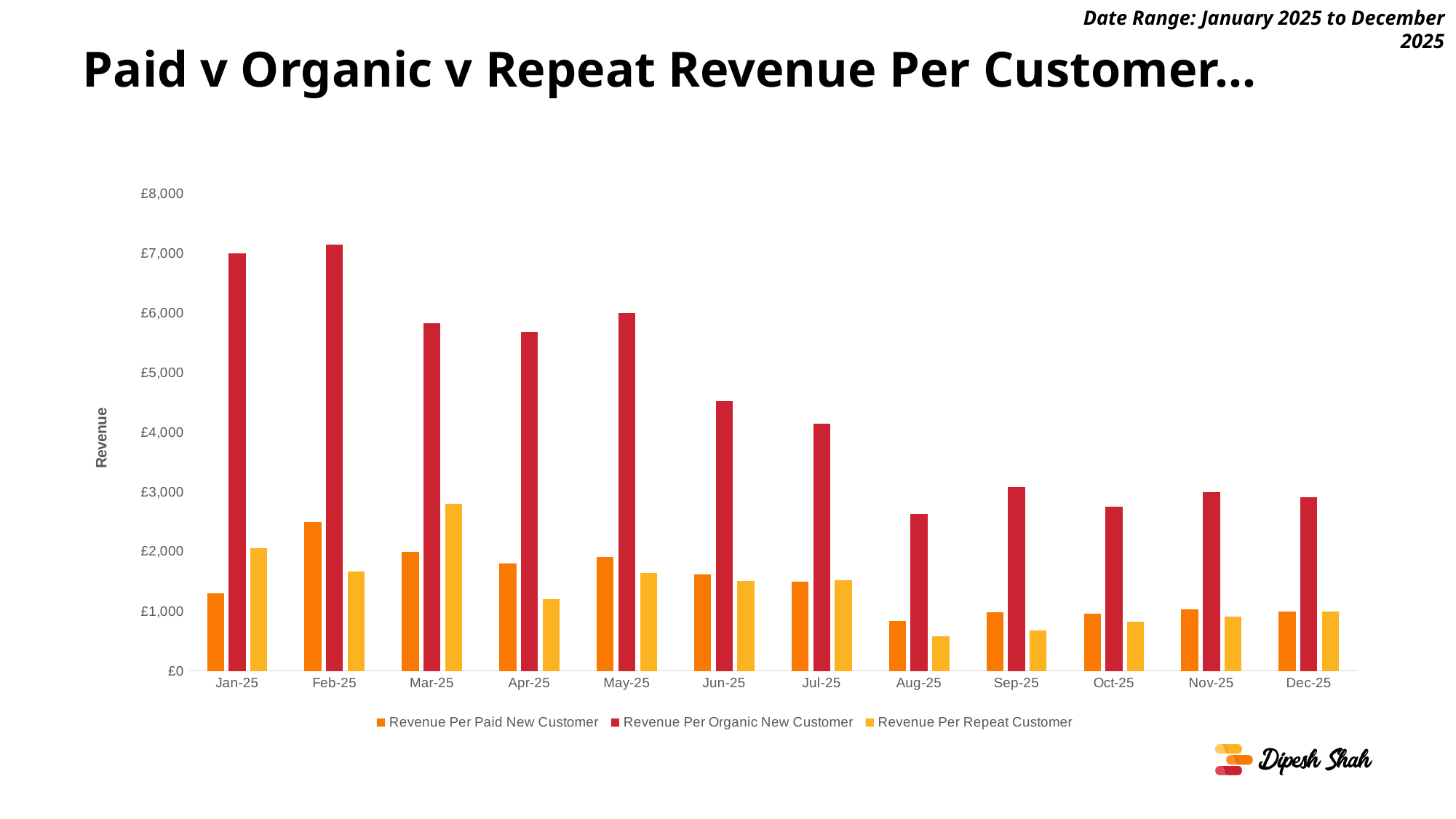
How many months are shown on the x axis? 12 Does Revenue Per Organic New Customer generally rise or fall from Jan-25 to Dec-25? Fall How many series does the legend list? 3 What is the title of the vertical axis? Revenue In which month is Revenue Per Repeat Customer lowest? Aug-25 Is the Revenue Per Organic New Customer for Jun-25 greater or less than £4,000? greater What kind of chart is shown on the slide? Bar chart In which month is Revenue Per Paid New Customer highest? Feb-25 Is the Revenue Per Organic New Customer for Aug-25 greater or less than £3,000? less In Jan-25, which is larger: Revenue Per Paid New Customer or Revenue Per Repeat Customer? Revenue Per Repeat Customer In which month is Revenue Per Repeat Customer highest? Mar-25 In which month is Revenue Per Organic New Customer highest? Feb-25